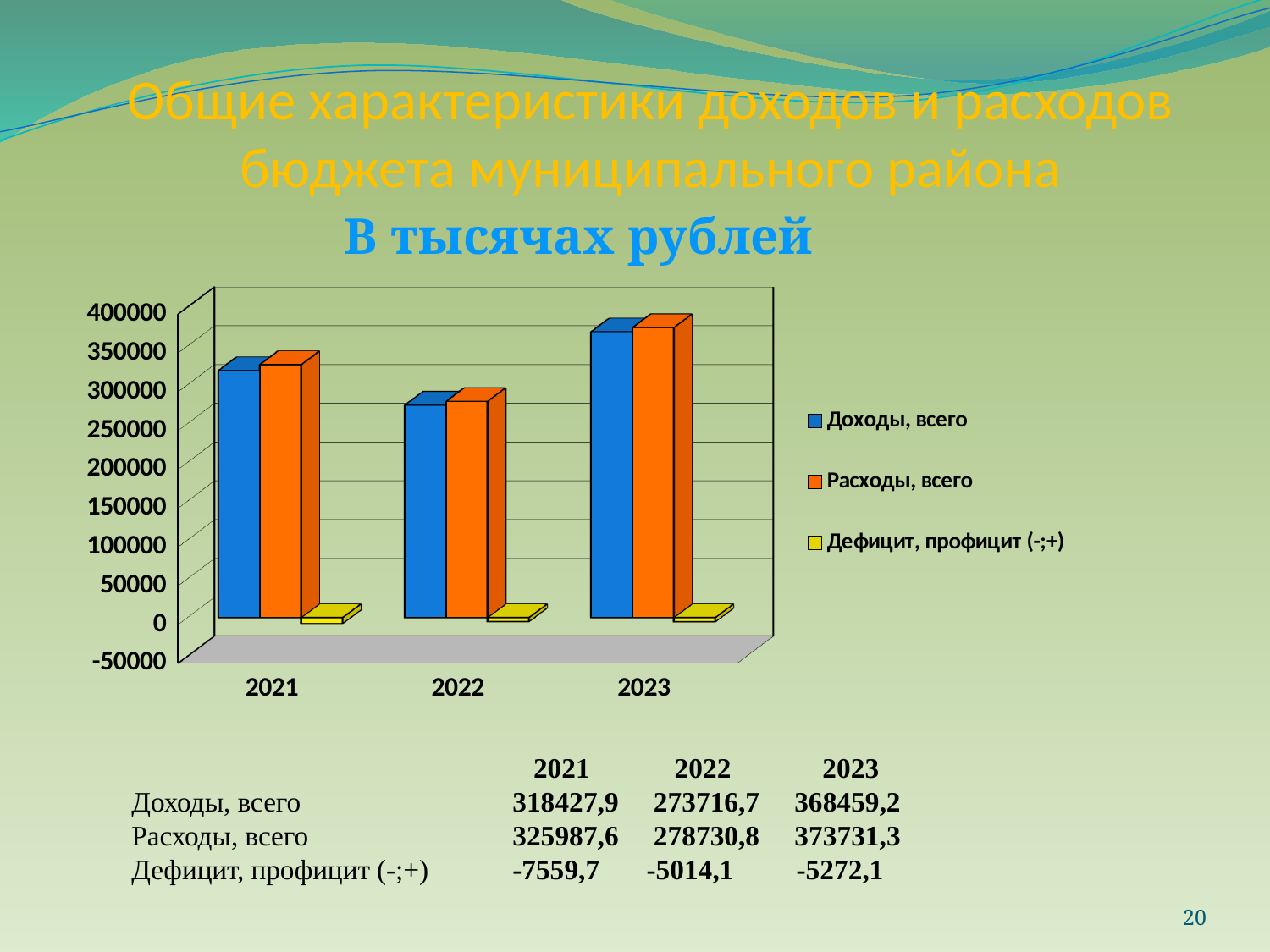
What is the value of Доходы, всего for 2021? 318427,9 By how much did Доходы, всего increase from 2022 to 2023? 94742,5 What kind of chart is shown on the slide? bar chart What is the difference between Расходы, всего and Доходы, всего in 2021? 7559,7 How many series does the chart legend list? 3 What is the value of Расходы, всего for 2023? 373731,3 What is the value of Дефицит, профицит (-;+) for 2022? -5014,1 How many years are shown on the x axis of the chart? 3 Is the value of Доходы, всего for 2022 greater or less than 300000? less In 2023, which is larger: Доходы, всего or Расходы, всего? Расходы, всего In which year is Доходы, всего the highest? 2023 In which year is Расходы, всего the lowest? 2022